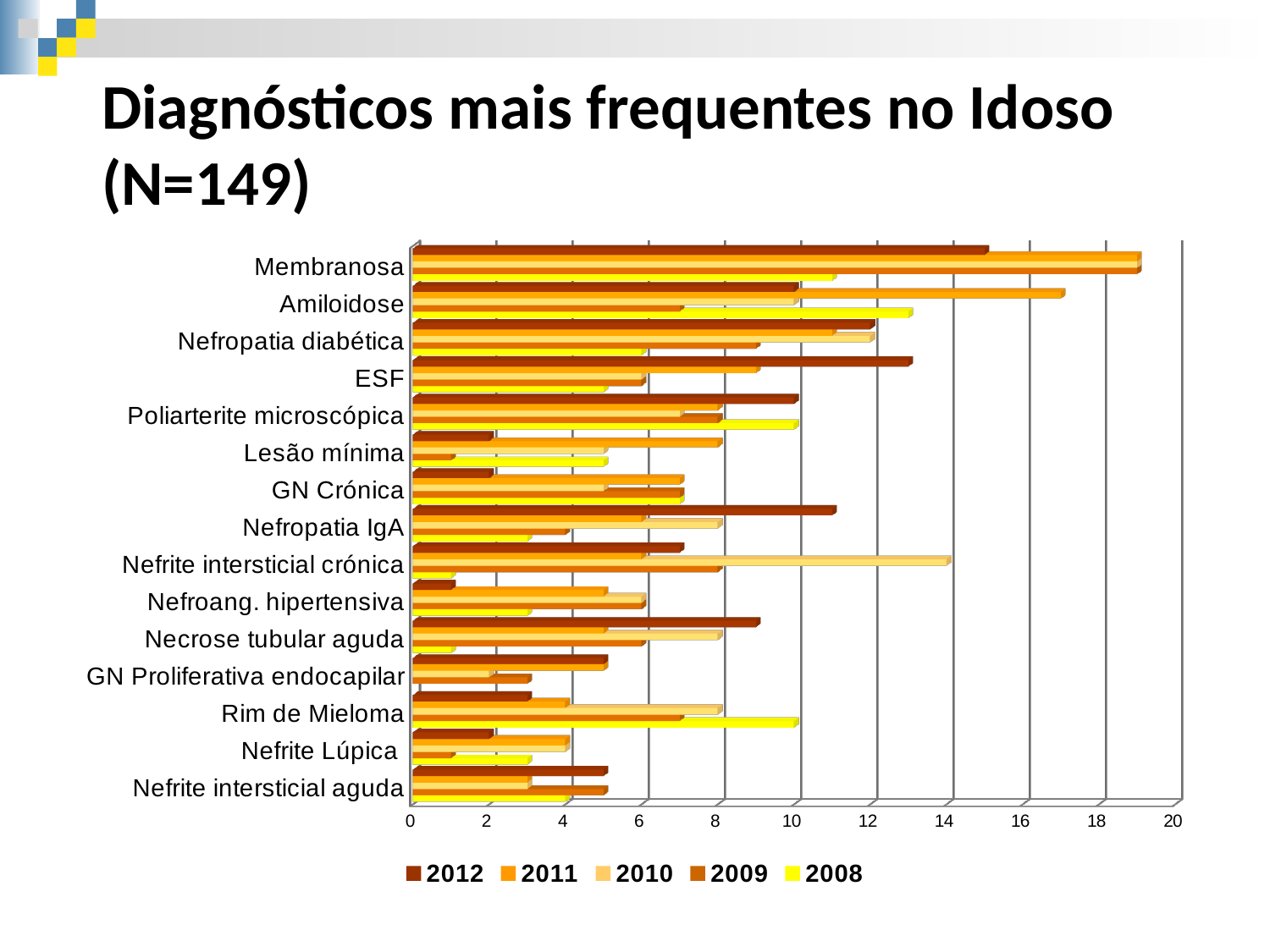
Which diagnosis has the highest 2011 value? Membranosa What is the title of the slide containing the chart? Diagnósticos mais frequentes no Idoso (N=149) Is the 2010 value for Nefrite intersticial crónica greater or less than 12? greater Which years are listed in the chart legend? 2012, 2011, 2010, 2009, 2008 Is the 2011 value for Membranosa greater or less than 18? greater Is the 2012 value for Nefroang. hipertensiva greater or less than 2? less For Rim de Mieloma, which year has the larger value, 2008 or 2012? 2008 Which diagnosis has the highest 2012 value? Membranosa How many diagnosis categories are listed on the vertical axis of the chart? 15 What kind of chart is shown on the slide? Bar chart How many series does the chart legend list? 5